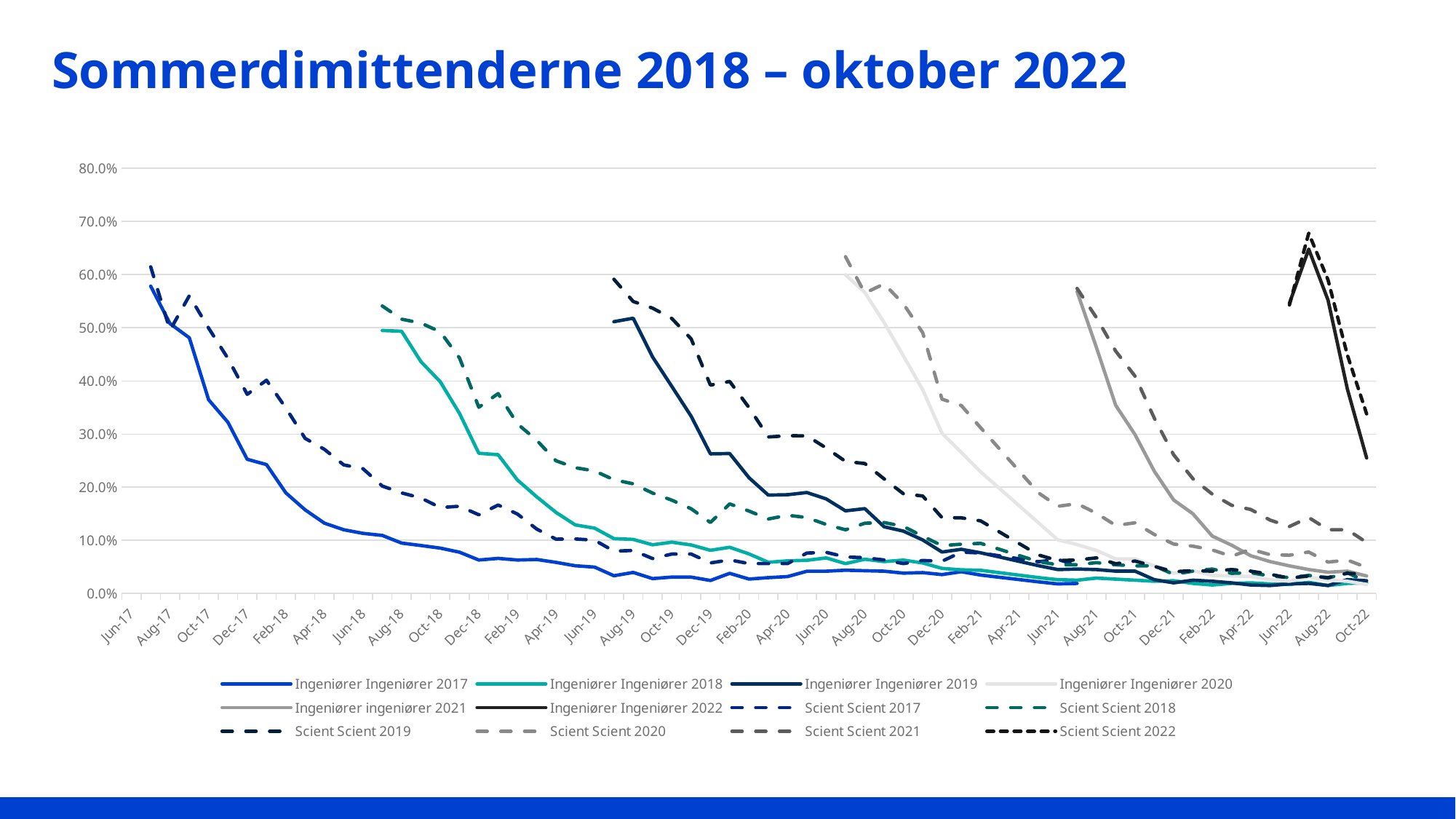
Is the peak value of Scient 2022 greater or less than 60.0%? greater What is the highest value shown on the y axis? 80.0% How many series does the legend list? 12 Is the value for Ingeniører 2018 at Aug-18 greater or less than 40.0%? greater What kind of chart is shown on the slide? line chart What is the title of the slide? Sommerdimittenderne 2018 – oktober 2022 Is the value for Ingeniører 2021 at Aug-21 greater or less than 50.0%? less Does the Ingeniører 2020 line rise or fall from Aug-20 to Jun-21? fall At Aug-19, which is larger: Scient 2019 or Ingeniører 2019? Scient 2019